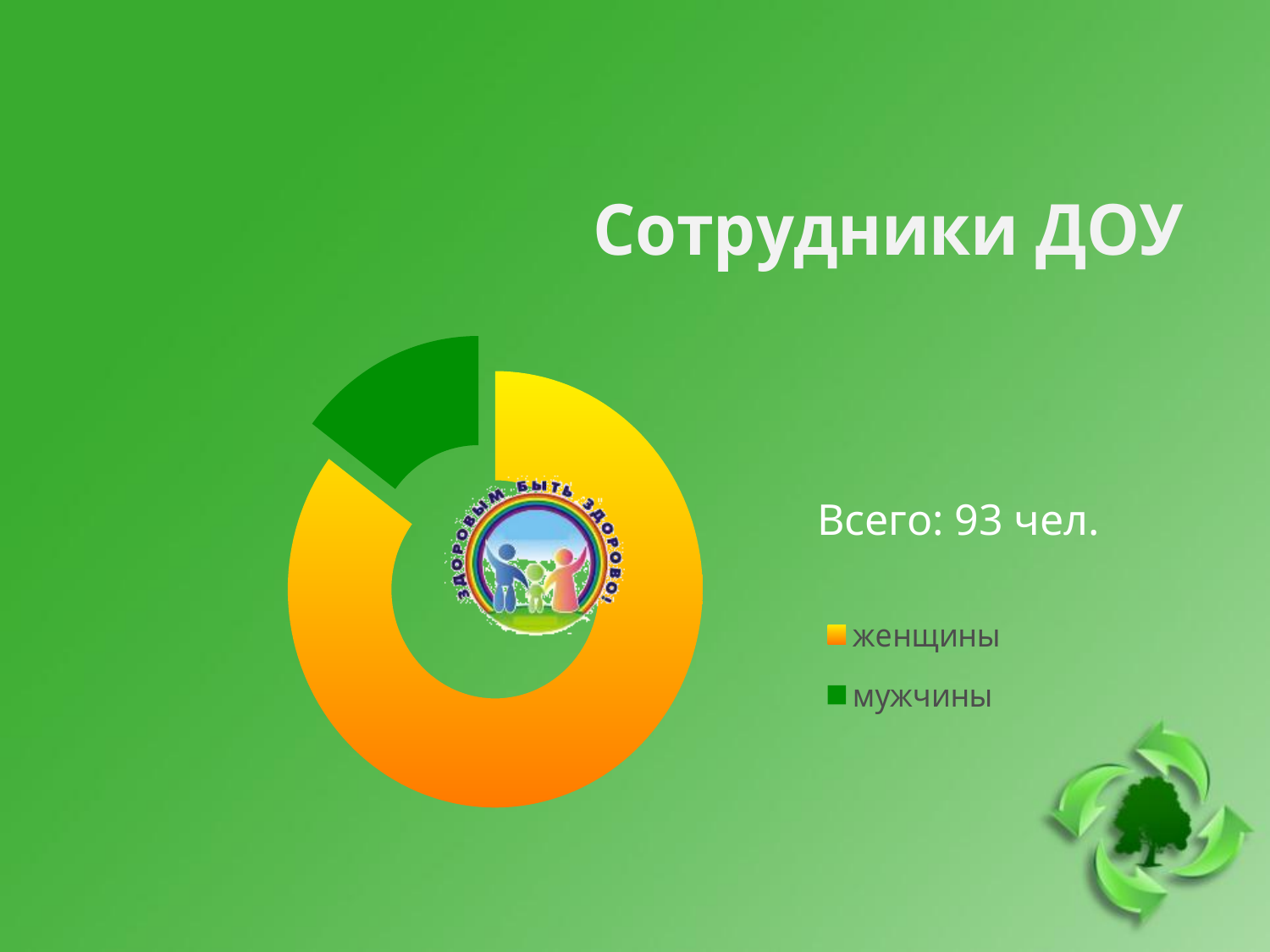
Which is larger, the share for женщины or the share for мужчины? женщины What colour represents мужчины in the chart? green Which category has the smallest share of the chart? мужчины What total number of people is stated next to the chart? 93 чел. Which category has the largest share of the chart? женщины What is the title of the slide containing the chart? Сотрудники ДОУ How many categories does the chart show? 2 What kind of chart is shown on the slide? doughnut chart How many entries does the legend list? 2